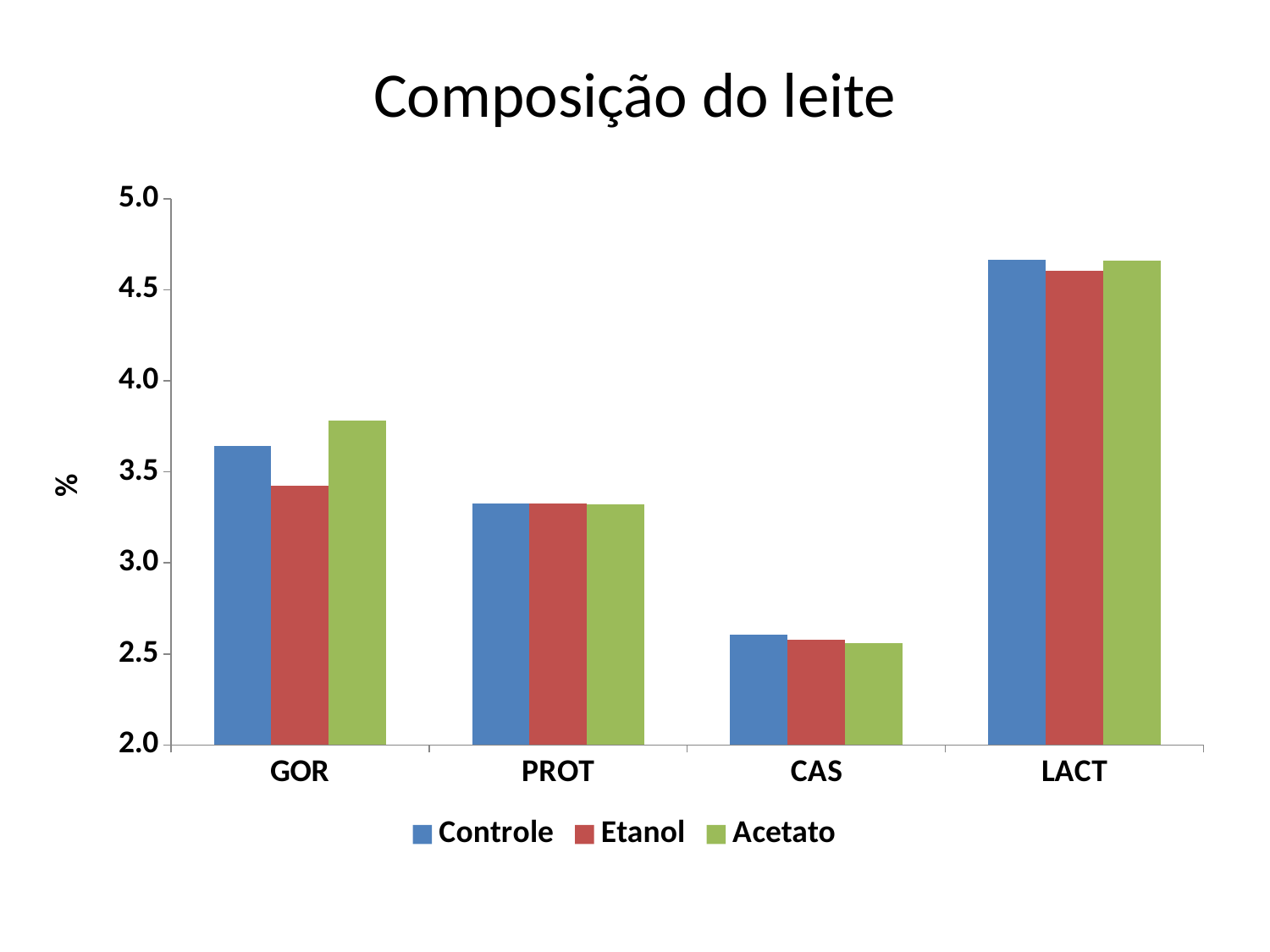
What kind of chart is shown on the slide? bar chart For the Controle series, which category has the highest value? LACT In the GOR category, which series has the highest bar? Acetato Is the Controle value for CAS greater or less than 3.0? less In the GOR category, which is larger: the Controle value or the Etanol value? Controle What is the title of the chart? Composição do leite How many series does the legend list? 3 In the GOR category, which series has the lowest bar? Etanol Is the Acetato value for GOR greater or less than 3.5? greater How many categories are shown on the x axis of the chart? 4 Is the Etanol value for LACT greater or less than 4.5? greater For the Controle series, which category has the lowest value? CAS